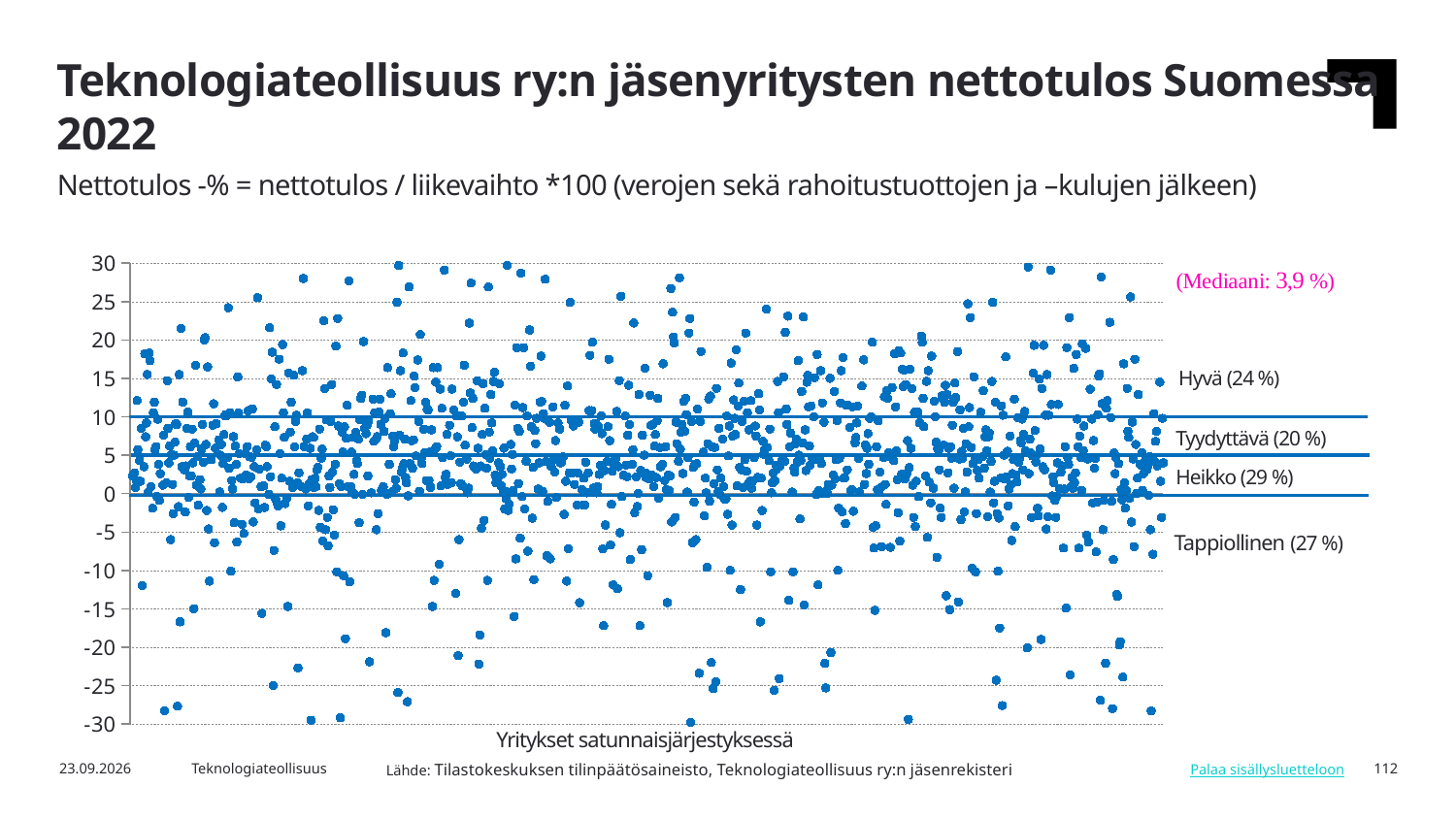
Which share is larger, Hyvä or Tappiollinen? Tappiollinen What is the label on the x axis of the chart? Yritykset satunnaisjärjestyksessä Which of the four labelled categories has the largest share of companies? Heikko What is the difference in percentage points between the Heikko share and the Tyydyttävä share? 9 How many labelled categories (Hyvä, Tyydyttävä, Heikko, Tappiollinen) are annotated on the chart? 4 What share of companies is labelled as Tappiollinen on the chart? 27 % What share of companies is labelled as Heikko on the chart? 29 % Which of the four labelled categories has the smallest share of companies? Tyydyttävä What share of companies is labelled as Hyvä on the chart? 24 % What share of companies is labelled as Tyydyttävä on the chart? 20 % What kind of chart is shown on the slide? scatter chart What median value is annotated on the chart? 3,9 %